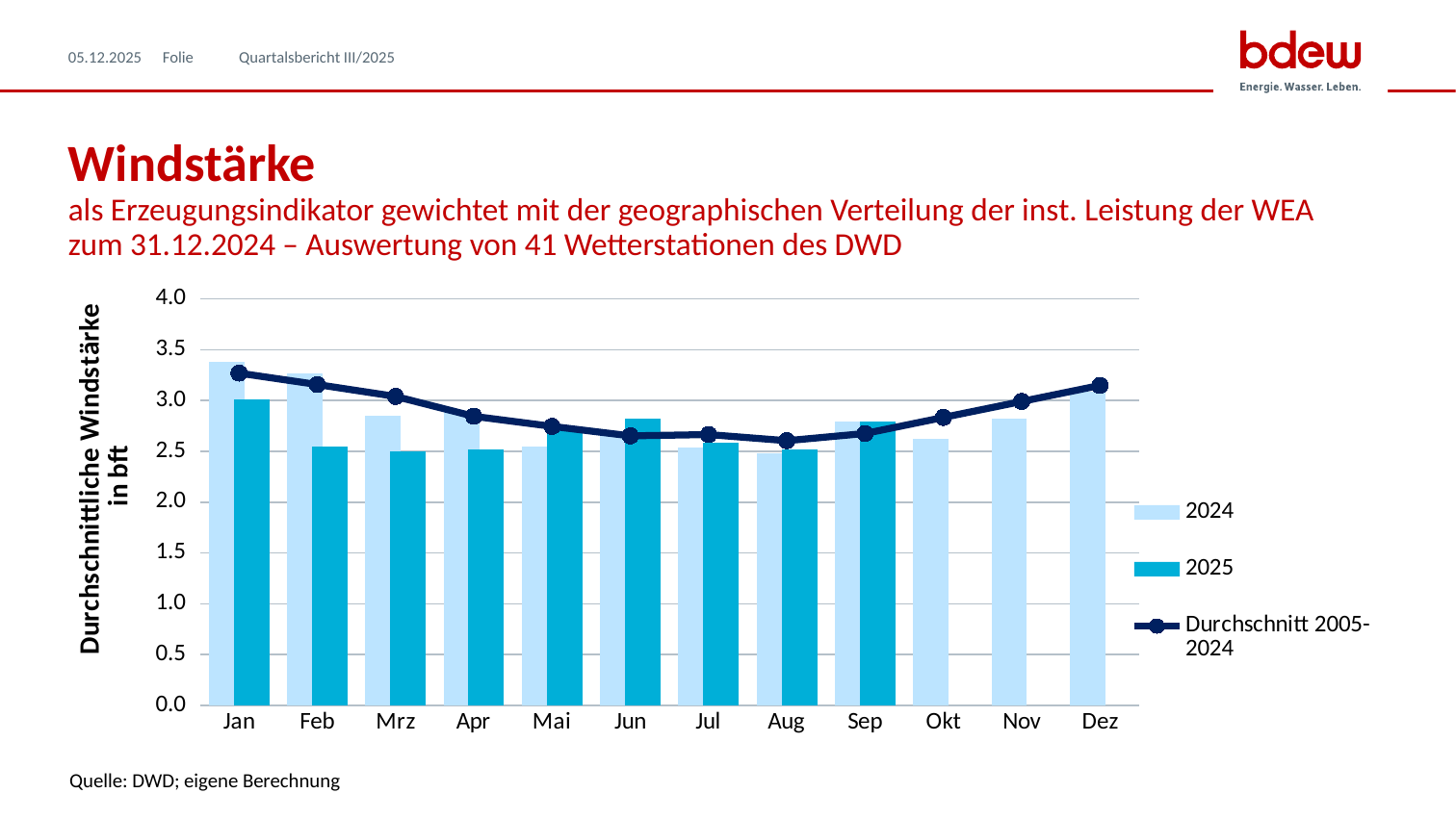
Which month has the highest 2024 value? Jan For how many months is a 2025 bar plotted? 9 What kind of chart is shown on the slide? bar chart with a line How many series does the legend list? 3 How many months are shown on the x axis? 12 What is the label of the y axis? Durchschnittliche Windstärke in bft In Jun, which is larger: the 2024 value or the 2025 value? 2025 Is the Durchschnitt 2005-2024 value for Aug greater or less than 3.0? less Is the 2024 value for Jan greater or less than 3.0? greater Does the Durchschnitt 2005-2024 line rise or fall from Jan to Aug? fall Is the 2025 value for Feb greater or less than 3.0? less Which month has the highest 2025 value? Jan